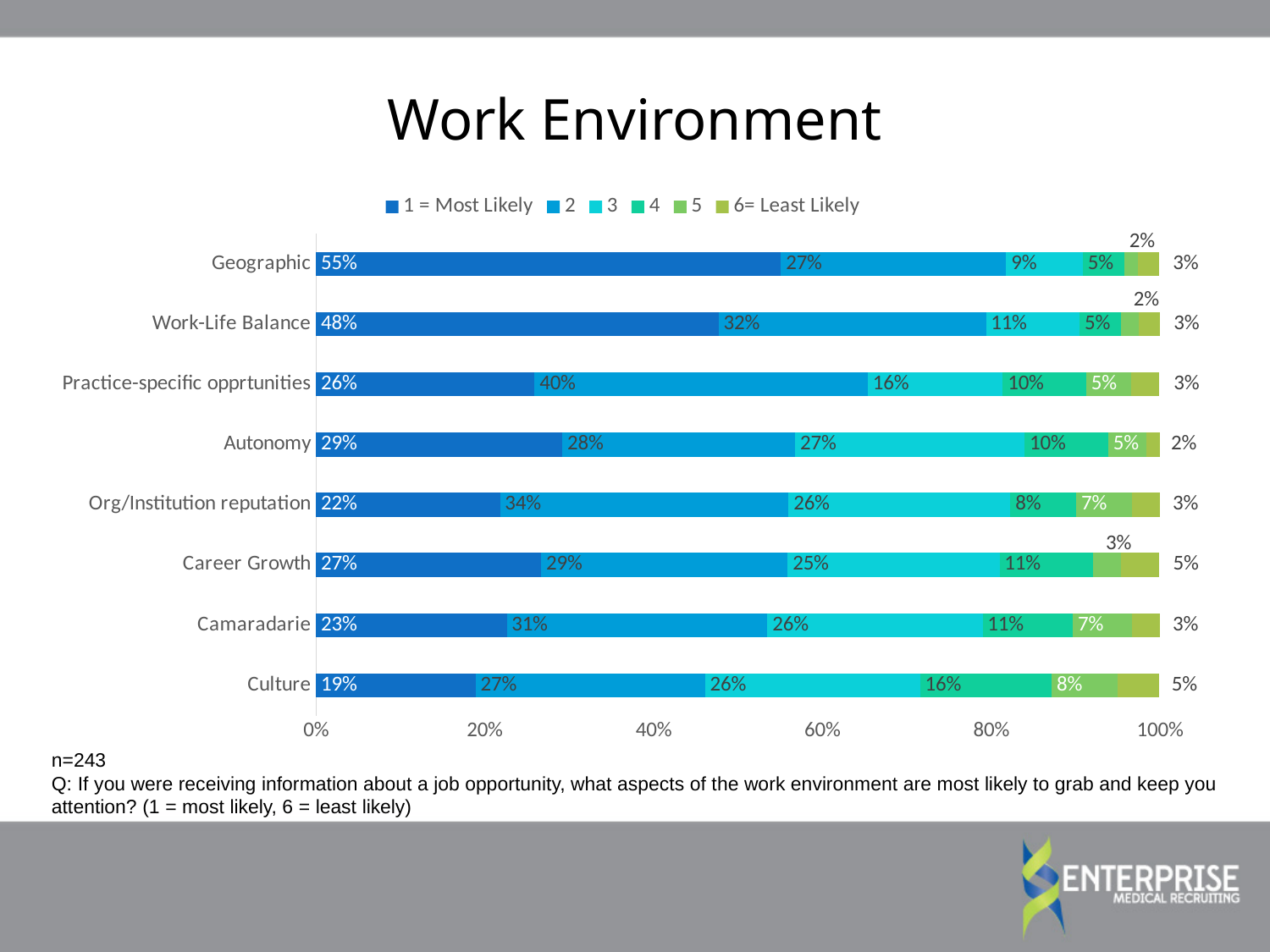
What is the value for the '2' series for Practice-specific opprtunities? 40% What percentage of respondents rated Geographic as 1 = Most Likely? 55% How many categories are shown on the chart? 8 What percentage rated Culture as 6= Least Likely? 5% What is the difference between the 1 = Most Likely values for Geographic and Work-Life Balance? 7% What kind of chart is shown on the slide? Stacked bar chart What is the title of the chart? Work Environment Which category has the highest value for 1 = Most Likely? Geographic Which has a larger '2' value, Org/Institution reputation or Camaradarie? Org/Institution reputation Which category has the lowest value for 1 = Most Likely? Culture What is the value for the '3' series for Autonomy? 27% How many series does the legend list? 6